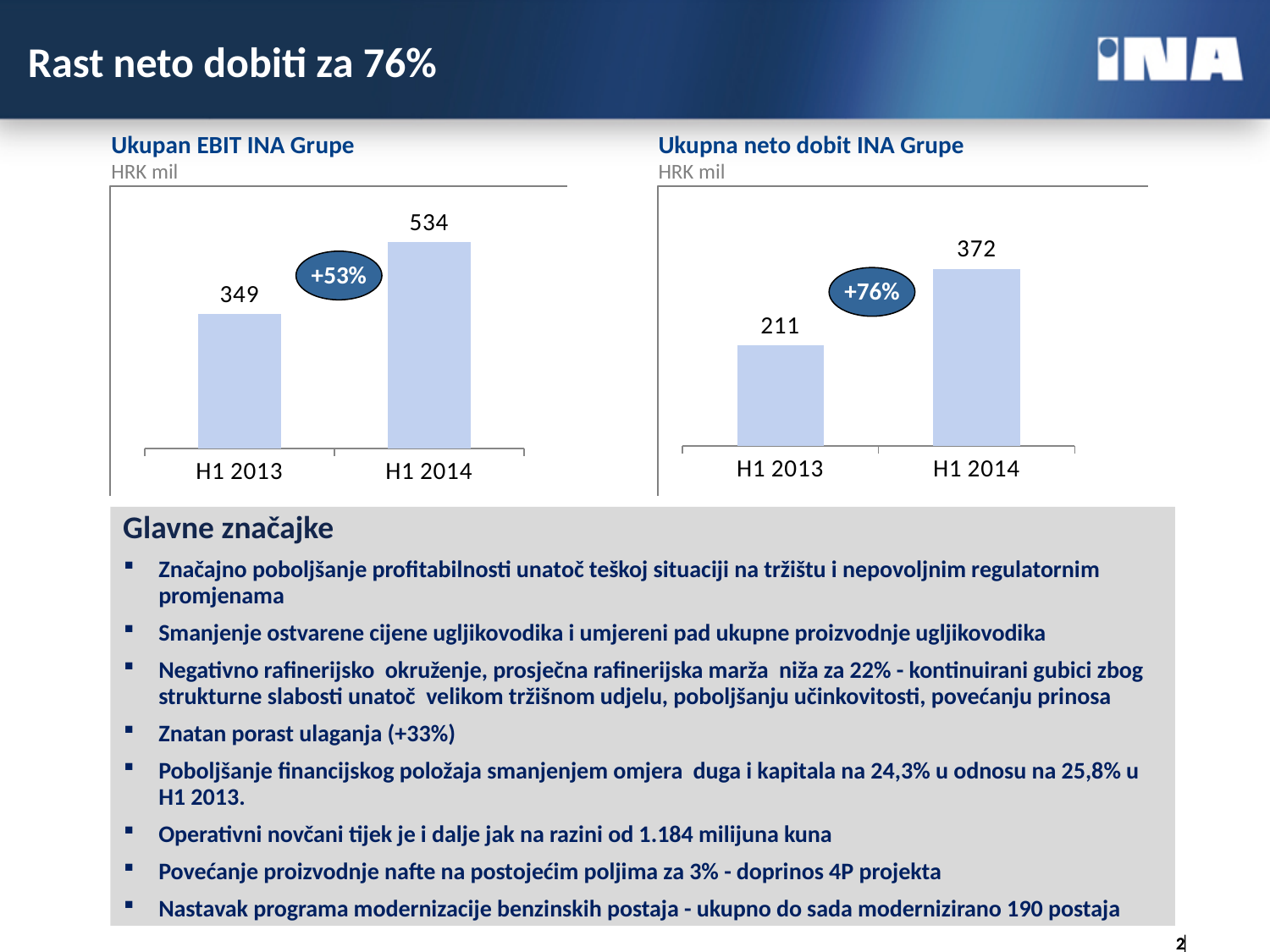
In the 'Ukupna neto dobit INA Grupe' chart, which period has the lowest value? H1 2013 In the 'Ukupna neto dobit INA Grupe' chart, what is the difference between the H1 2014 and H1 2013 values? 161 In the 'Ukupna neto dobit INA Grupe' chart, what is the value for H1 2014? 372 In the 'Ukupna neto dobit INA Grupe' chart, do the values rise or fall from H1 2013 to H1 2014? rise In the 'Ukupna neto dobit INA Grupe' chart, what is the value for H1 2013? 211 In the 'Ukupan EBIT INA Grupe' chart, which period has the higher value? H1 2014 In the 'Ukupan EBIT INA Grupe' chart, what is the value for H1 2013? 349 In the 'Ukupan EBIT INA Grupe' chart, what is the difference between the H1 2014 and H1 2013 values? 185 How many categories are shown in the 'Ukupna neto dobit INA Grupe' chart? 2 What kind of chart is the 'Ukupan EBIT INA Grupe' chart? bar chart In the 'Ukupan EBIT INA Grupe' chart, what is the value for H1 2014? 534 What percentage change is shown in the callout on the 'Ukupan EBIT INA Grupe' chart? +53%